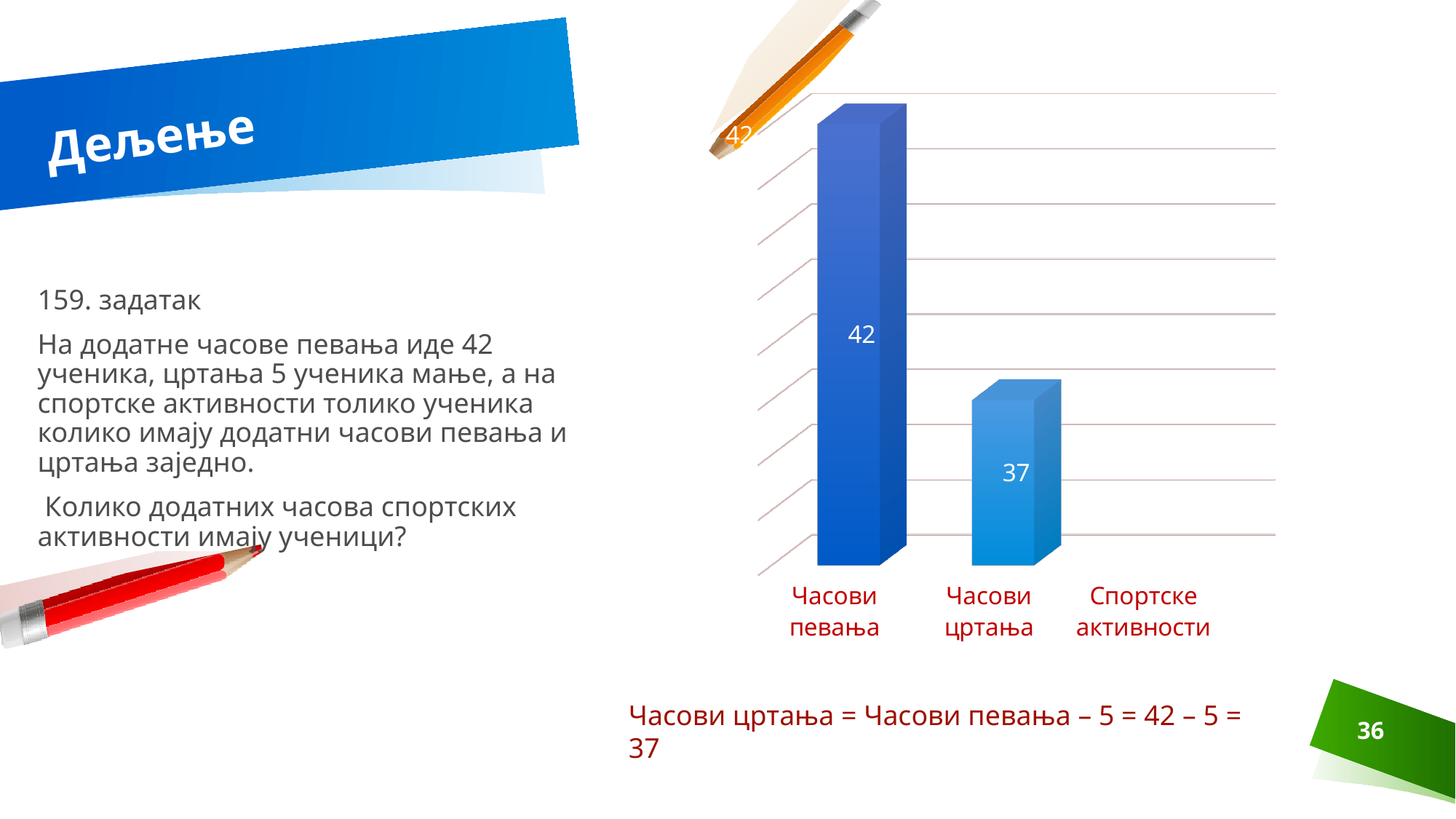
Which of the plotted bars is the shortest? Часови цртања What is the label of the third category on the x axis? Спортске активности Which category has the tallest bar? Часови певања How many bars are actually plotted on the chart? 2 What is the value for Часови певања? 42 What is the value for Часови цртања? 37 Which is larger, the value for Часови певања or the value for Часови цртања? Часови певања What is the difference between the values for Часови певања and Часови цртања? 5 How many categories are labelled on the x axis? 3 What kind of chart is shown on the slide? bar chart Which category on the x axis has no bar plotted? Спортске активности Do the plotted values rise or fall from Часови певања to Часови цртања? fall